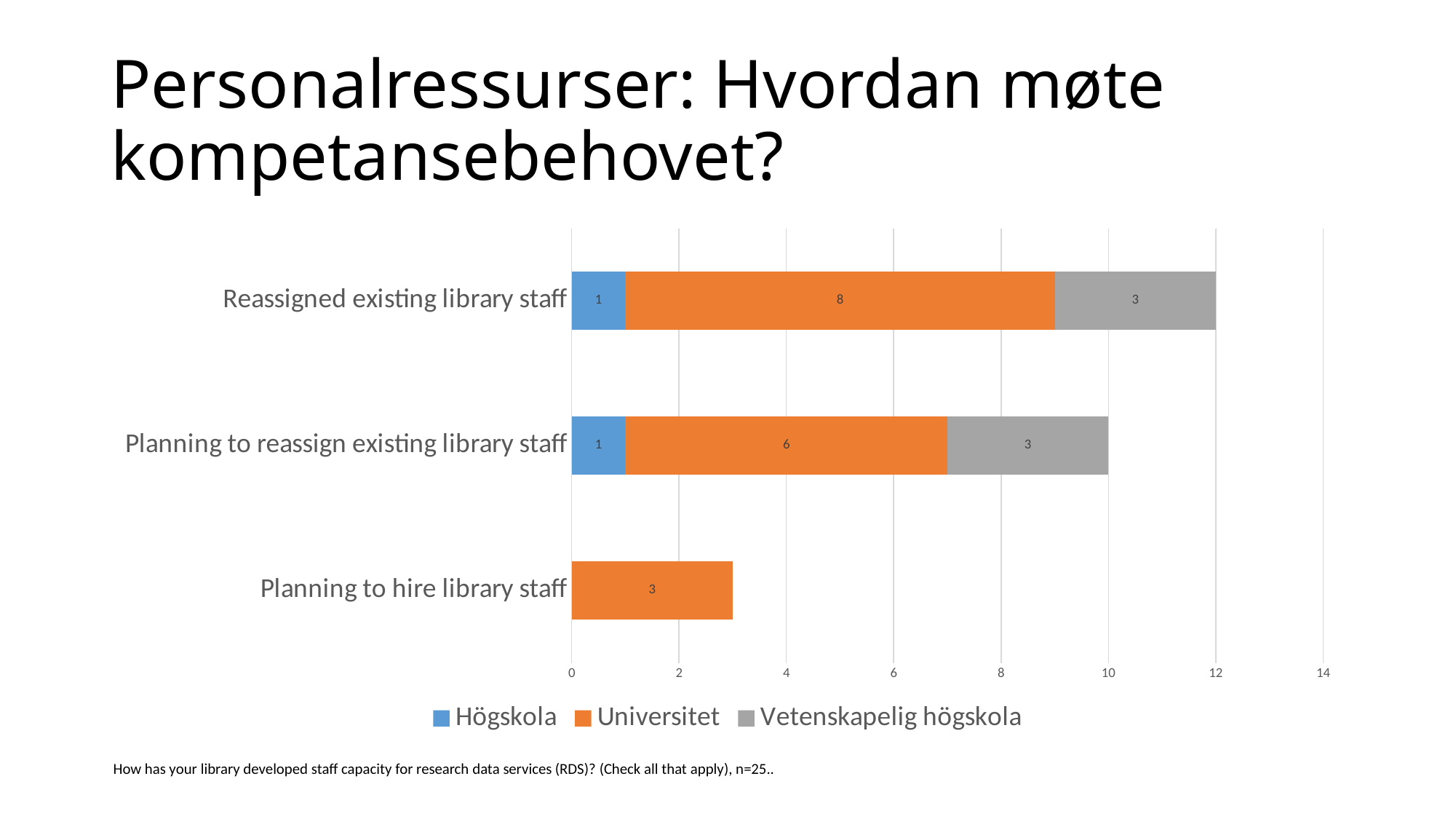
Which is larger: the Universitet value for Reassigned existing library staff or the Universitet value for Planning to hire library staff? Reassigned existing library staff Which category has the longest total stacked bar? Reassigned existing library staff What is the total of the stacked bar for Reassigned existing library staff? 12 What is the Vetenskapelig högskola value for Planning to reassign existing library staff? 3 How many categories are shown on the chart? 3 What is the Högskola value for Reassigned existing library staff? 1 What is the Universitet value for Planning to hire library staff? 3 What is the total of the stacked bar for Planning to reassign existing library staff? 10 What is the Universitet value for Reassigned existing library staff? 8 Which category has the shortest total stacked bar? Planning to hire library staff How many series does the legend list? 3 What is the difference between the Universitet values for Reassigned existing library staff and Planning to reassign existing library staff? 2